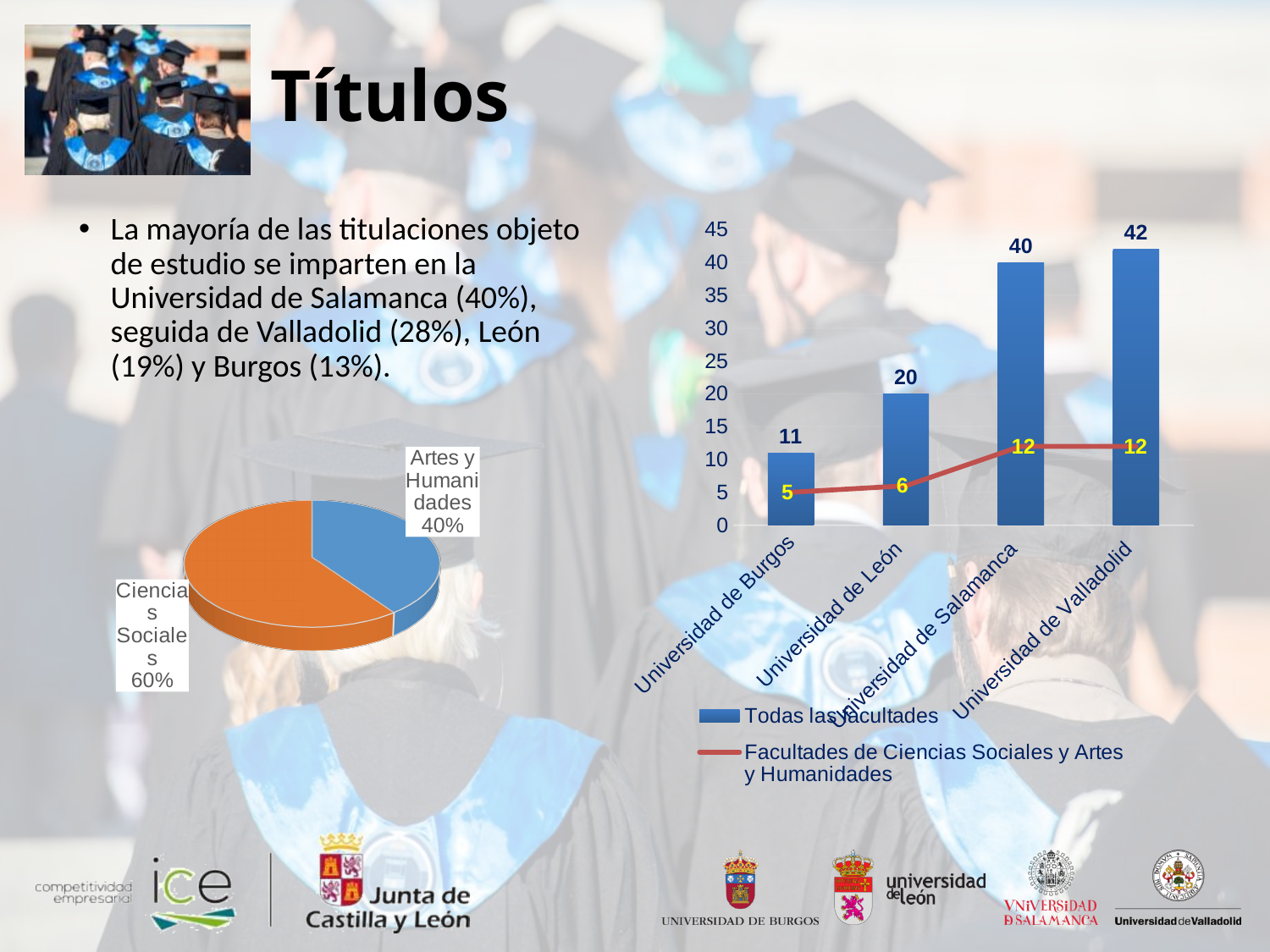
In the bar chart on the right, what is the value of 'Todas las facultades' for Universidad de Salamanca? 40 In the chart on the right, do the 'Todas las facultades' values rise or fall from Universidad de Burgos to Universidad de Valladolid? rise In the bar chart on the right, what is the value of 'Todas las facultades' for Universidad de Burgos? 11 In the bar chart on the right, what is the value of 'Facultades de Ciencias Sociales y Artes y Humanidades' for Universidad de León? 6 In the bar chart on the right, what is the difference between the 'Todas las facultades' values for Universidad de Salamanca and Universidad de León? 20 What kind of chart is the chart on the left of the slide? pie chart In the bar chart on the right, which university has the highest value for 'Todas las facultades'? Universidad de Valladolid How many series does the legend of the chart on the right list? 2 In the bar chart on the right, which is larger for 'Todas las facultades': Universidad de León or Universidad de Burgos? Universidad de León In the pie chart on the left, what share does 'Ciencias Sociales' have? 60% In the bar chart on the right, which university has the lowest value for 'Todas las facultades'? Universidad de Burgos How many universities are shown on the x axis of the bar chart on the right? 4